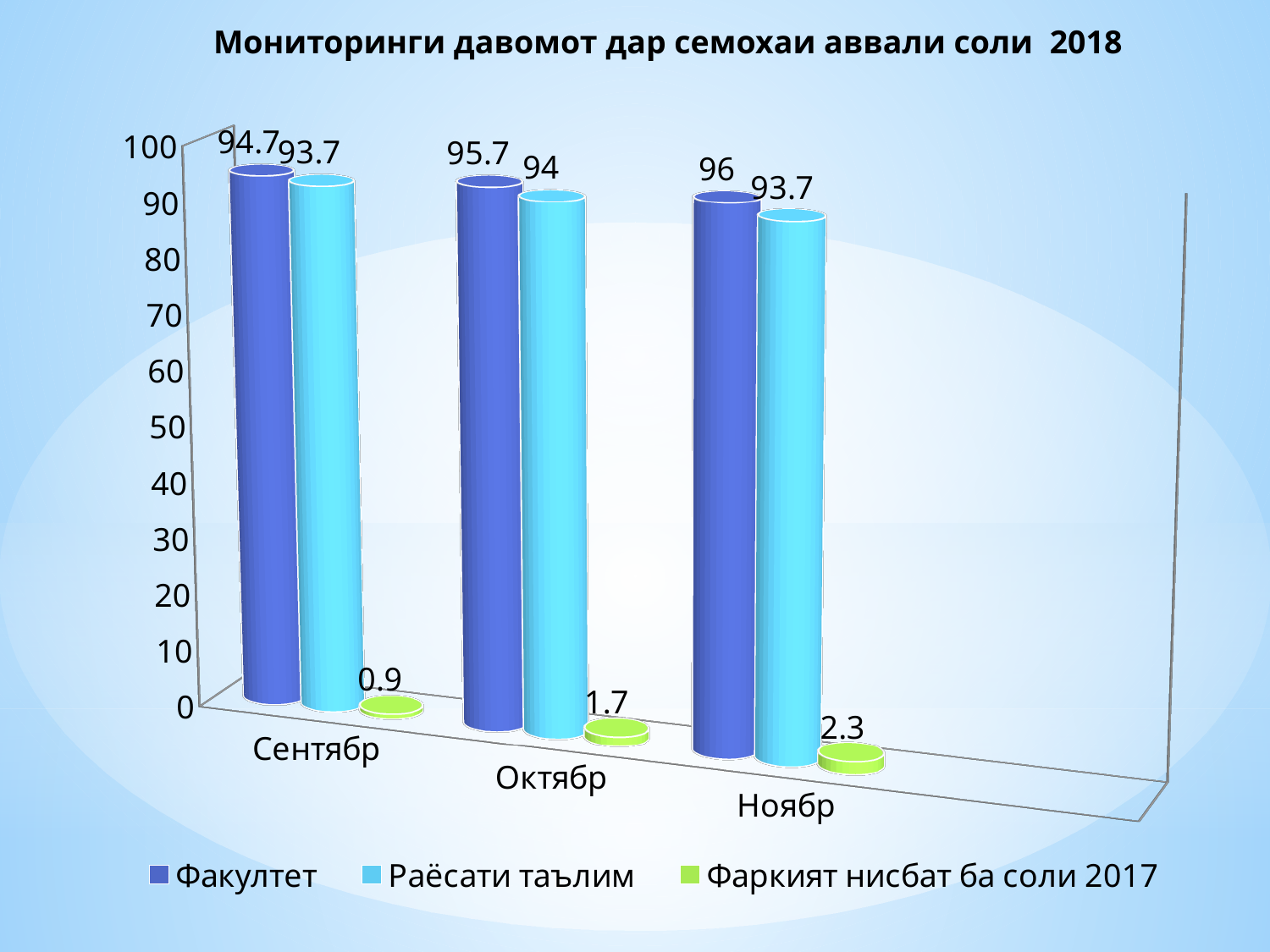
What kind of chart is shown on the slide? bar chart How many series does the legend list? 3 In which month is the Фаркият нисбат ба соли 2017 value lowest? Сентябр What is the value for Раёсати таълим in Сентябр? 93.7 Which is larger in Октябр: the Факултет value or the Раёсати таълим value? Факултет What is the value for Факултет in Октябр? 95.7 What is the difference between the Факултет and Раёсати таълим values in Ноябр? 2.3 What is the value for Фаркият нисбат ба соли 2017 in Ноябр? 2.3 How many months are shown on the x axis? 3 Is the value for Раёсати таълим in Ноябр greater or less than 90? greater Do the Фаркият нисбат ба соли 2017 values rise or fall from Сентябр to Ноябр? rise In which month is the Факултет value highest? Ноябр